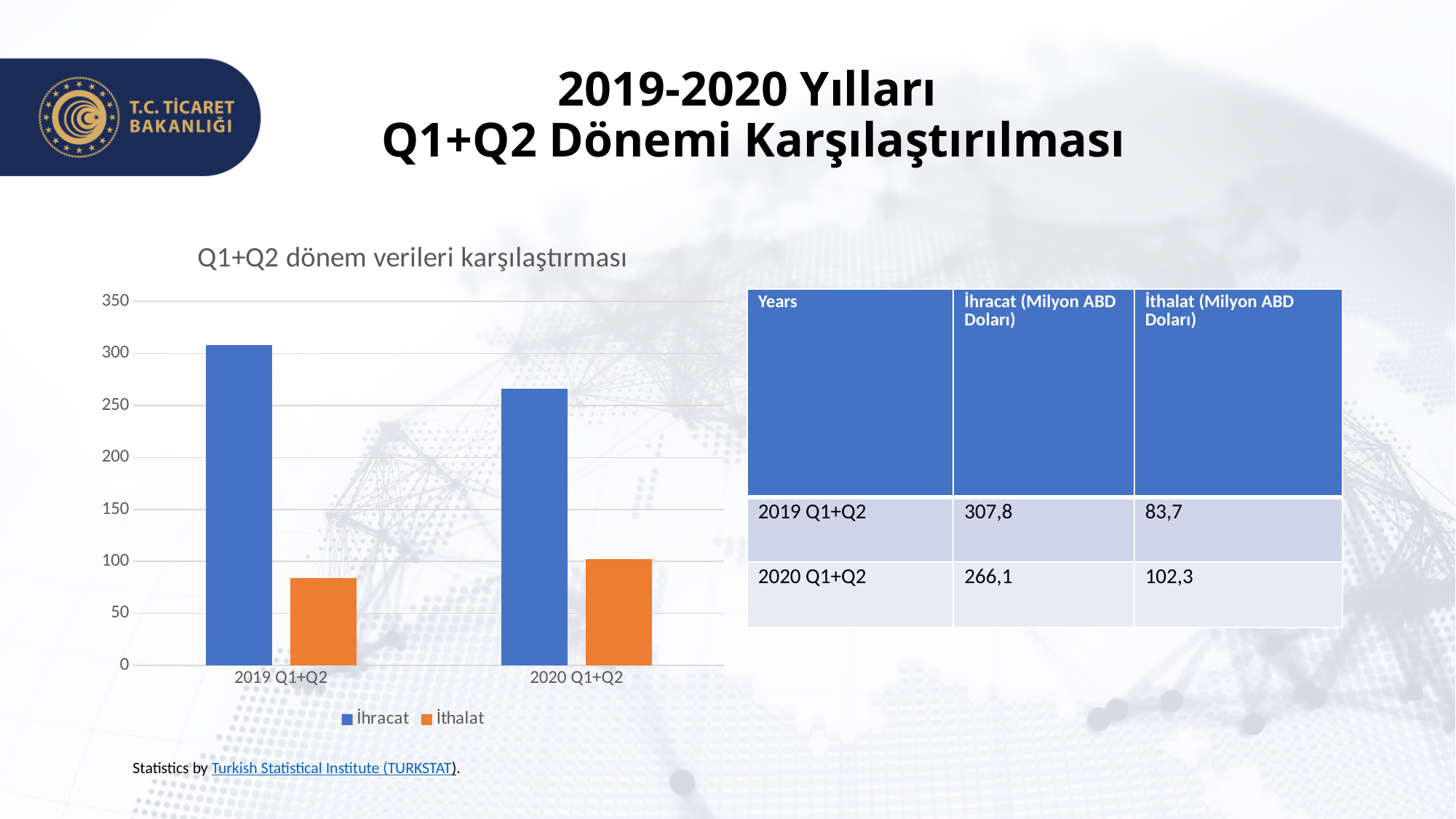
What is the İthalat value for 2020 Q1+Q2? 102,3 How many categories are shown on the x axis of the chart? 2 Is the İhracat value for 2020 Q1+Q2 greater or less than 250? greater Which category has the lowest İthalat value? 2019 Q1+Q2 How many series does the chart legend list? 2 Which category has the highest İhracat value? 2019 Q1+Q2 Which is larger, İhracat or İthalat for 2020 Q1+Q2? İhracat What kind of chart is shown on the slide? bar chart What is the title of the chart? Q1+Q2 dönem verileri karşılaştırması Does the İthalat value rise or fall from 2019 Q1+Q2 to 2020 Q1+Q2? rise What is the İhracat value for 2019 Q1+Q2? 307,8 What is the difference between the İhracat values for 2019 Q1+Q2 and 2020 Q1+Q2? 41,7